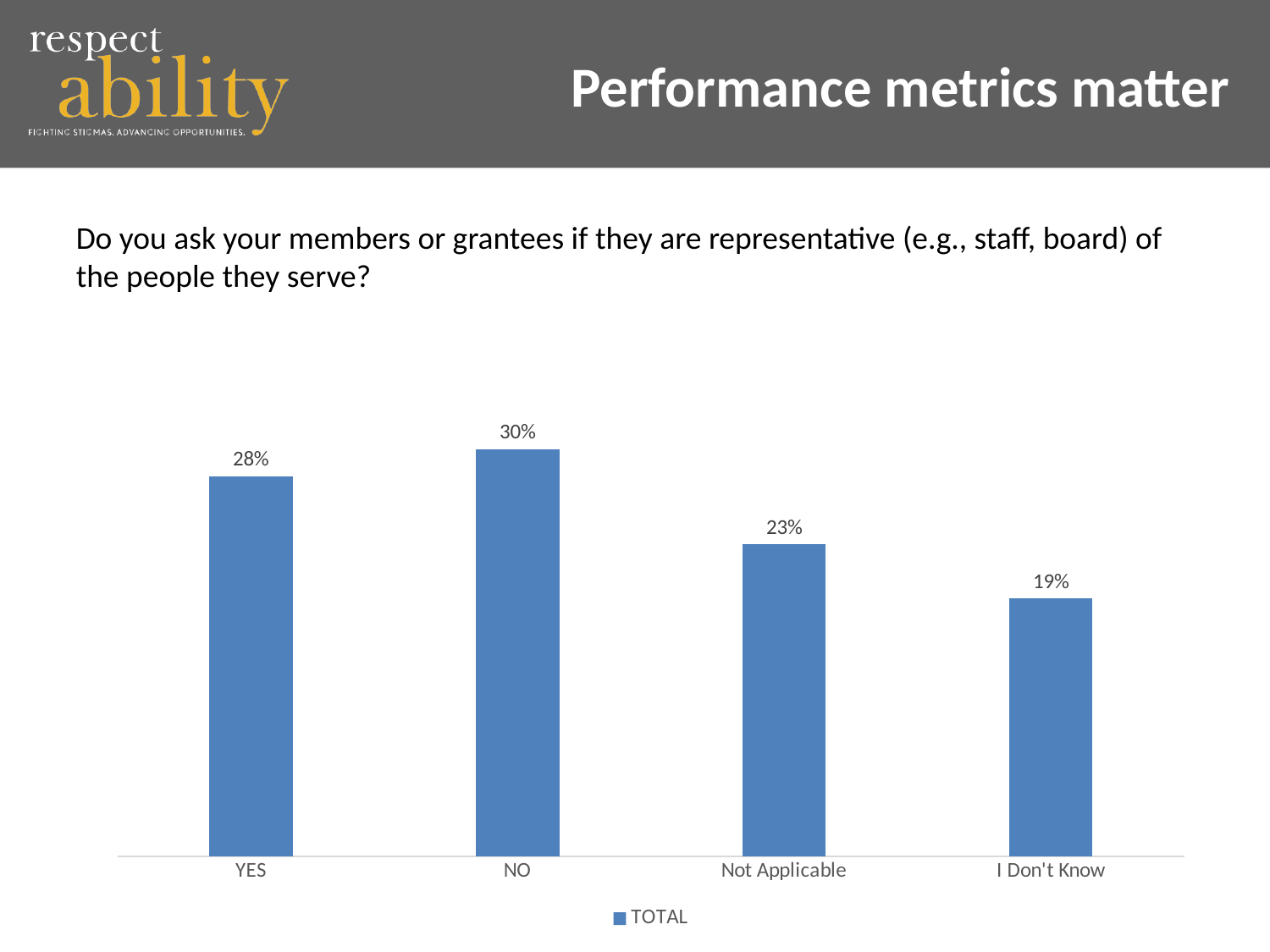
Which category has the lowest value? I Don't Know Which category has the highest value? NO What is the value for I Don't Know? 19% Which is larger, the value for YES or the value for Not Applicable? YES How many categories are shown on the chart? 4 What is the value for Not Applicable? 23% What is the value for NO? 30% What is the difference between the values for Not Applicable and I Don't Know? 4% What series name does the legend show? TOTAL What is the difference between the values for NO and YES? 2% What kind of chart is shown on the slide? Bar chart What is the value for YES? 28%